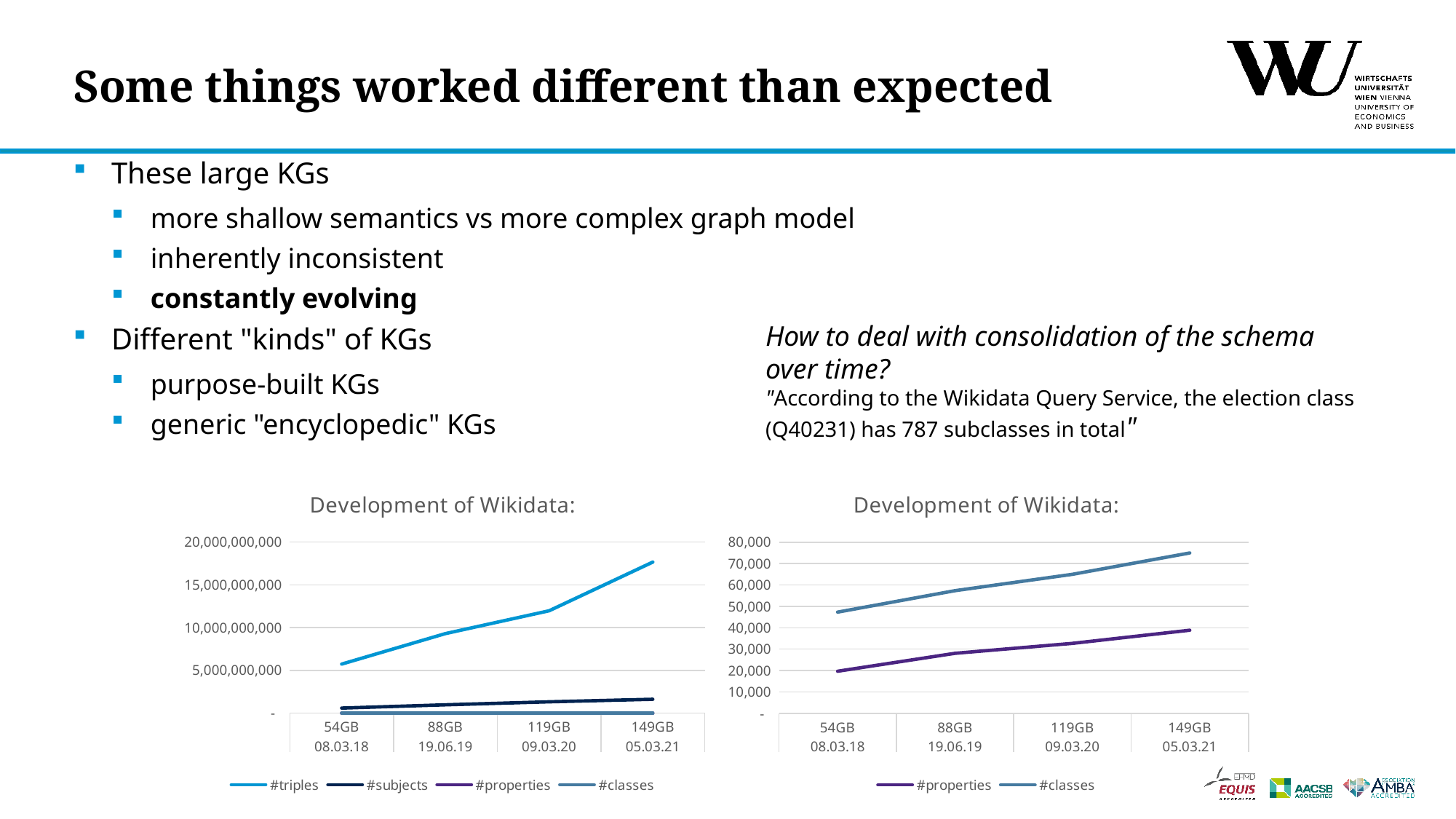
How many series does the legend of the left chart list? 4 In the right chart, is the value of #classes at 54GB (08.03.18) greater or less than 50,000? less In the left chart, which series has the highest values? #triples What is the title of the right chart? Development of Wikidata: In the left chart, is the value of #triples at 149GB (05.03.21) greater or less than 15,000,000,000? greater How many series does the legend of the right chart list? 2 In the right chart, which series has the lower values, #properties or #classes? #properties In the left chart, is the value of #triples at 54GB (08.03.18) greater or less than 5,000,000,000? greater In the right chart, do the values of #classes rise or fall along the x axis? rise How many points along the x axis does the right chart have? 4 What type of chart is the left chart on the slide? line chart